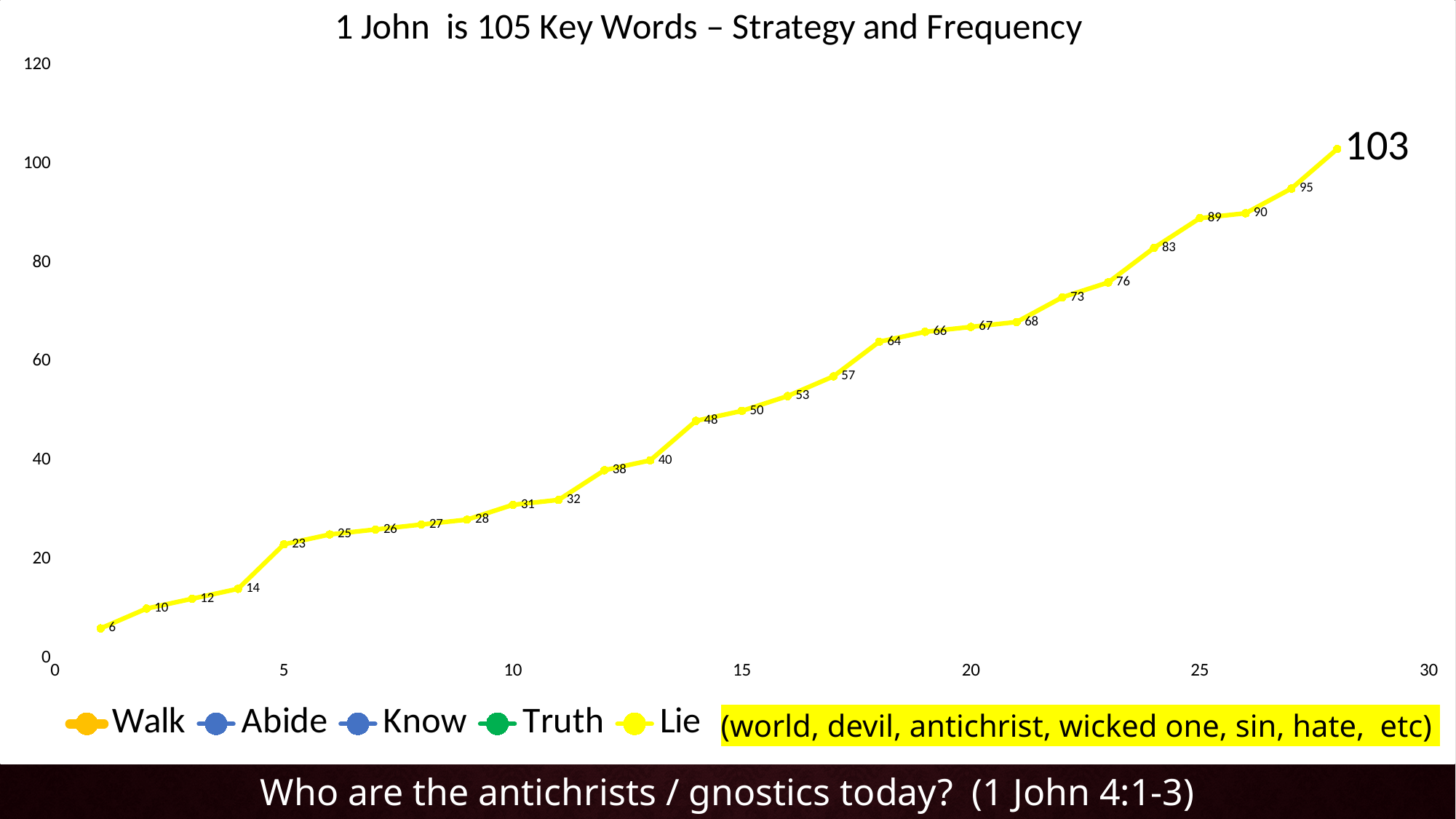
Do the values of the Lie series rise or fall along the x axis? rise What is the value of the Lie series at x = 20? 67 What is the difference between the highest and lowest values on the Lie line? 97 What colour is the Lie series in the legend? yellow What is the lowest value plotted on the Lie line? 6 What is the value of the Lie series at x = 5? 23 What is the value of the Lie series at x = 25? 89 How many series does the legend list? 5 What is the highest value plotted on the Lie line? 103 What is the value of the Lie series at x = 10? 31 How many data points are plotted on the Lie line? 28 What kind of chart is shown on the slide? line chart